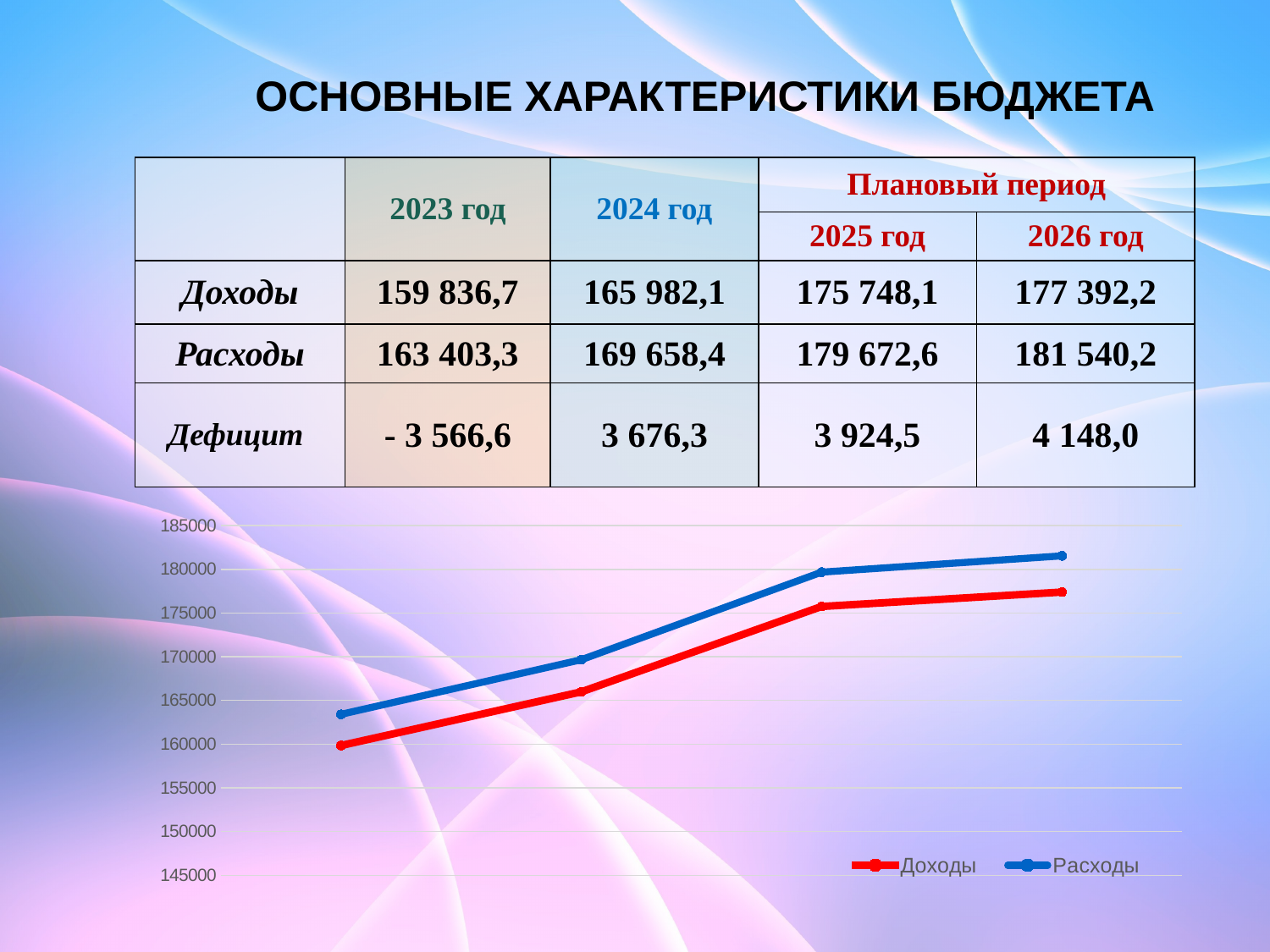
How many series does the legend of the line chart list? 2 Is the value of the Расходы line at its last point greater or less than 180000? greater What is the highest value shown on the vertical axis of the line chart? 185000 Do the values of the Расходы line rise or fall from left to right? rise Is the value of the Доходы line at its first point greater or less than 165000? less Do the values of the Доходы line rise or fall from left to right? rise Which colour is the Расходы line in the chart? blue What kind of chart is shown at the bottom of the slide? line chart At the last point of the chart, which line is higher, Доходы or Расходы? Расходы Is the value of the Расходы line at its first point greater or less than 160000? greater How many data points does each line in the chart have? 4 What are the two series named in the legend of the line chart? Доходы and Расходы